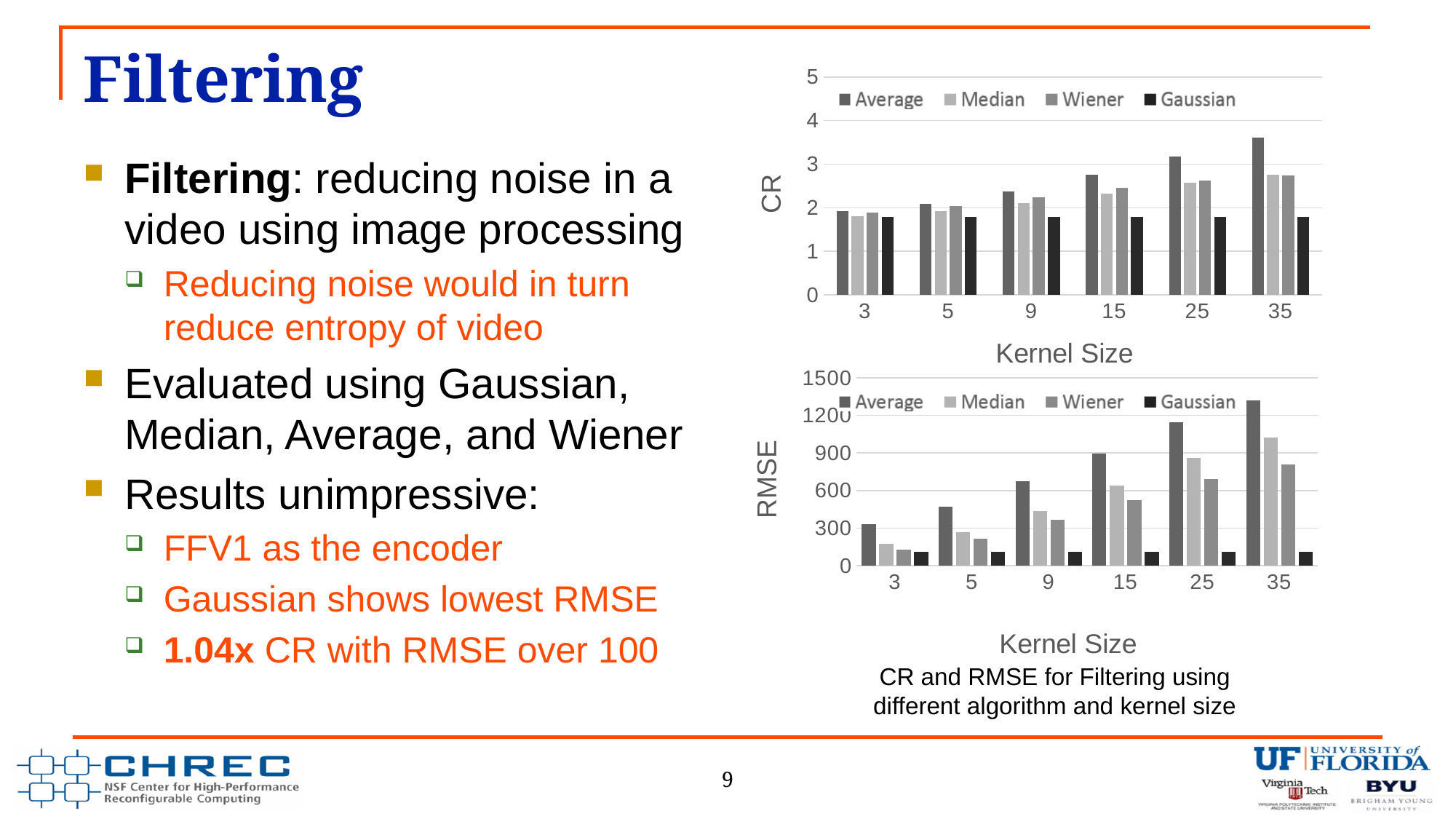
What kind of chart is the top chart (CR vs Kernel Size)? bar chart In the top chart (CR), which series has the highest bar at kernel size 35? Average In the bottom chart (RMSE), is the value for Average at kernel size 35 greater or less than 1200? greater What is the x-axis label of the bottom chart? Kernel Size In the top chart (CR), is the value for Average at kernel size 35 greater or less than 3? greater In the bottom chart (RMSE), at kernel size 25, which is larger: Average or Wiener? Average In the bottom chart (RMSE), which series has the lowest bar at kernel size 25? Gaussian In the top chart (CR), is the value for Gaussian at kernel size 3 greater or less than 2? less In the top chart (CR), does the Average series rise or fall as kernel size increases? rise How many series does the legend of the top chart (CR) list? 4 How many kernel sizes are shown on the x axis of the bottom chart (RMSE vs Kernel Size)? 6